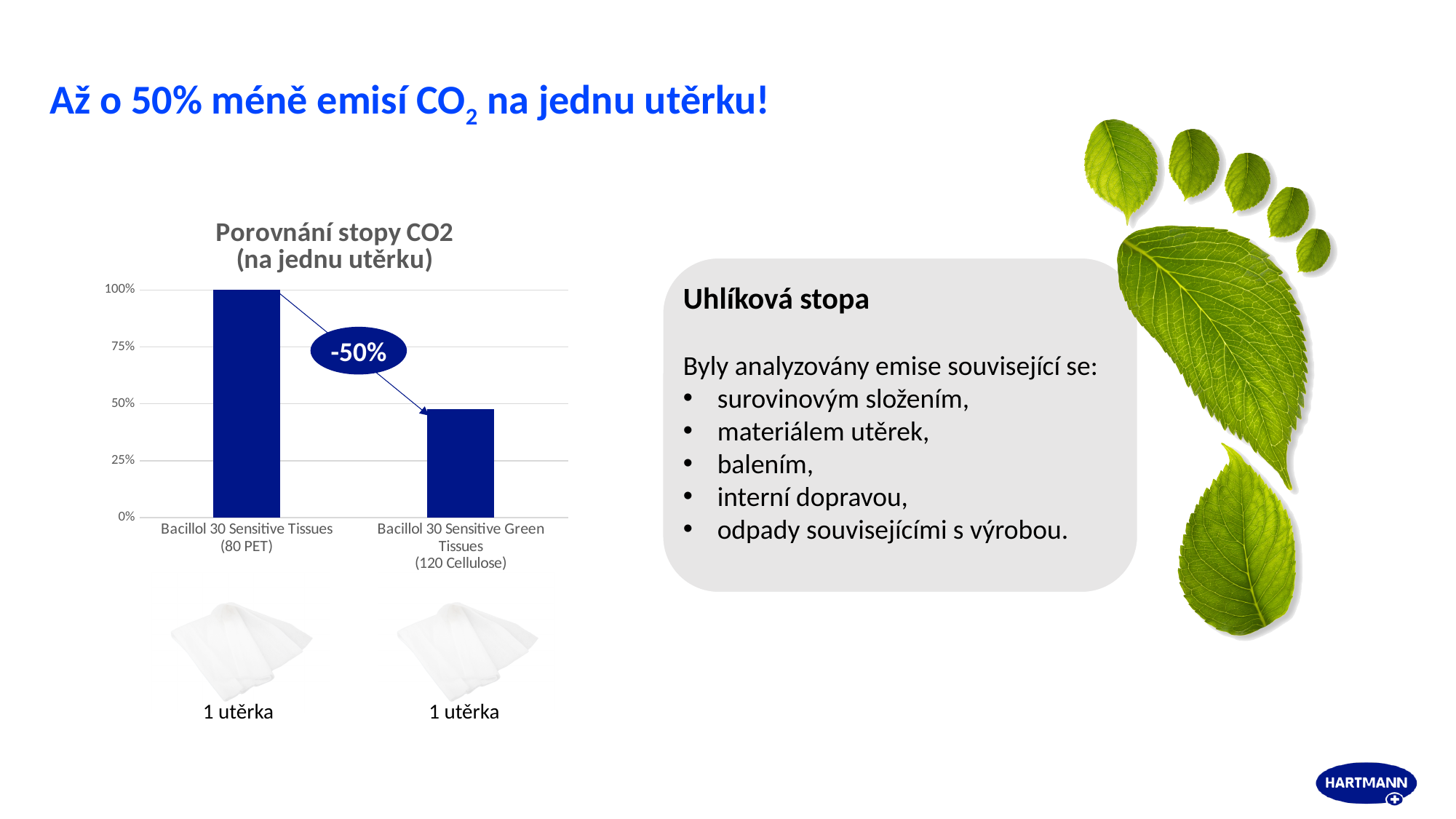
What is the title of the chart? Porovnání stopy CO2 (na jednu utěrku) What is the value for Bacillol 30 Sensitive Tissues (80 PET)? 100% Which category has the lowest value in the chart? Bacillol 30 Sensitive Green Tissues (120 Cellulose) What kind of chart is shown on the slide? bar chart Which has a larger value: Bacillol 30 Sensitive Tissues (80 PET) or Bacillol 30 Sensitive Green Tissues (120 Cellulose)? Bacillol 30 Sensitive Tissues (80 PET) How many bars are plotted in the chart? 2 Which category has the highest value in the chart? Bacillol 30 Sensitive Tissues (80 PET) Is the value for Bacillol 30 Sensitive Green Tissues (120 Cellulose) greater or less than 75%? less Is the value for Bacillol 30 Sensitive Green Tissues (120 Cellulose) greater or less than 25%? greater What label is shown in the oval annotation on the arrow between the two bars? -50% Do the values rise or fall from the left bar to the right bar? fall